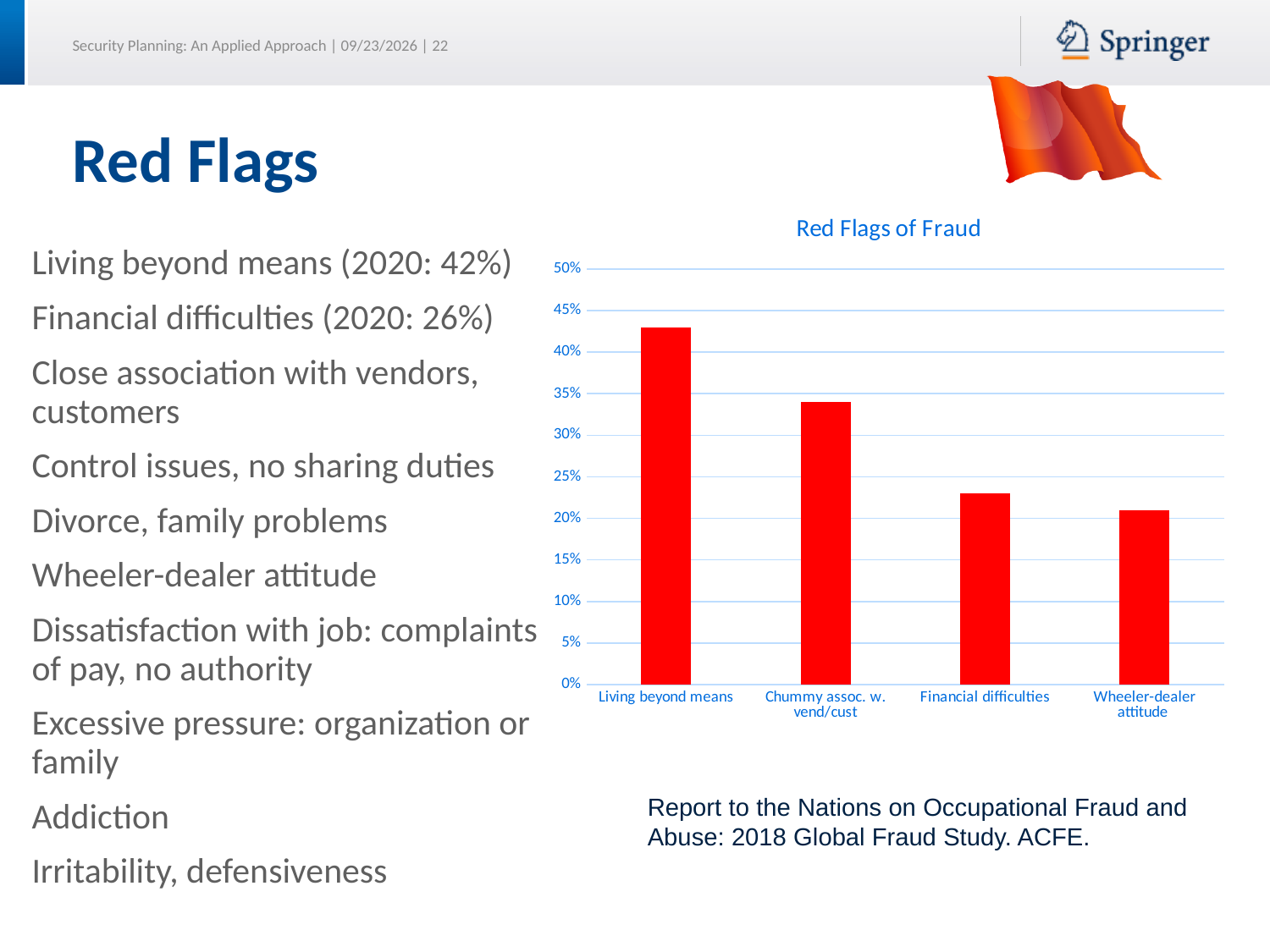
Is the value for Financial difficulties greater or less than 25%? less What colour are the bars in the chart? red Is the value for Wheeler-dealer attitude greater or less than 25%? less Do the values rise or fall from left to right across the categories? fall Which is larger, the value for Living beyond means or the value for Chummy assoc. w. vend/cust? Living beyond means What kind of chart is shown on the slide? bar chart Which category has the highest value in the chart? Living beyond means Which category has the lowest value in the chart? Wheeler-dealer attitude What is the title of the chart? Red Flags of Fraud Is the value for Chummy assoc. w. vend/cust greater or less than 30%? greater How many categories are plotted in the chart? 4